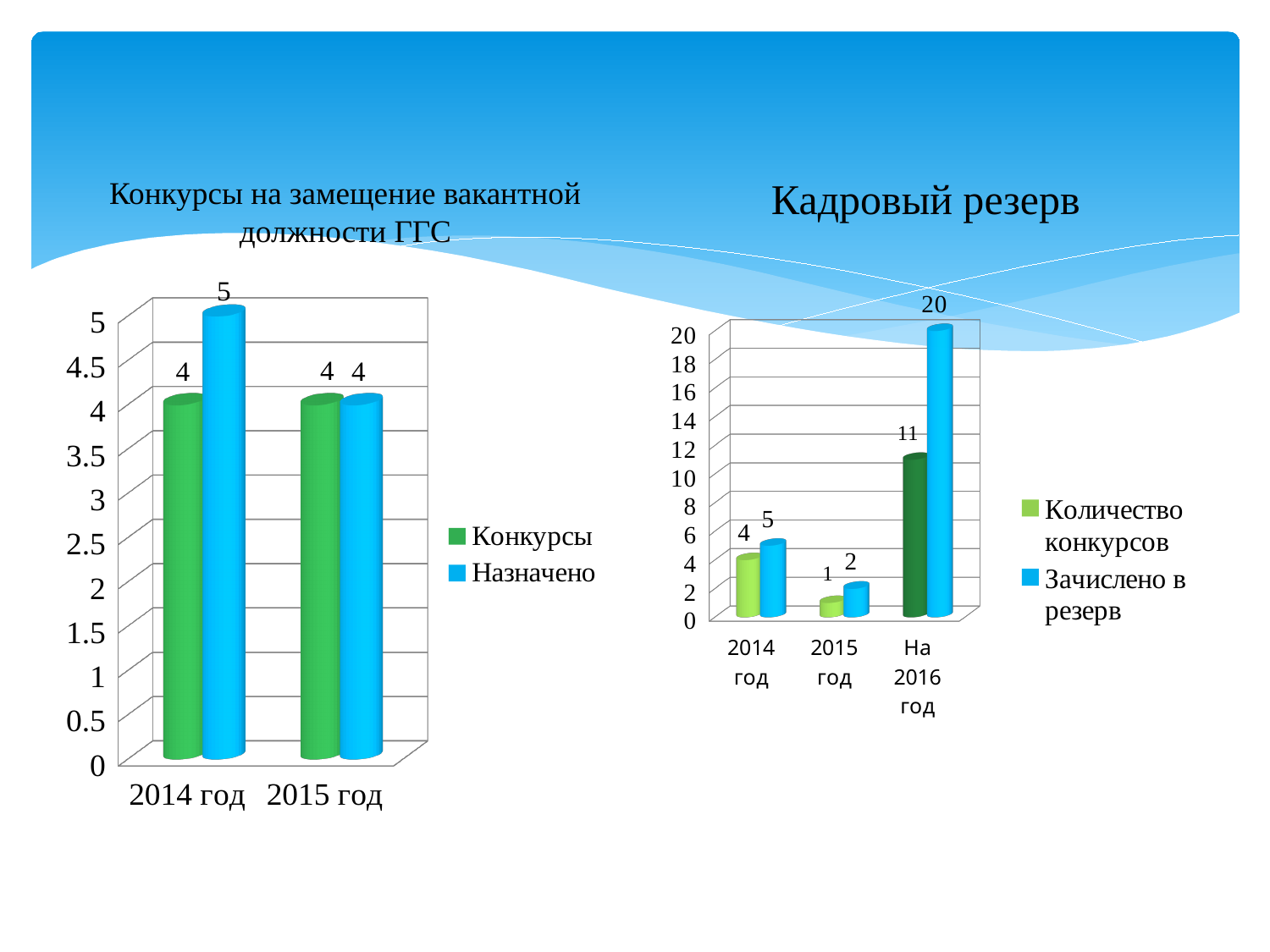
In the chart titled "Кадровый резерв", which is larger for 2014 год: "Количество конкурсов" or "Зачислено в резерв"? Зачислено в резерв In the chart titled "Конкурсы на замещение вакантной должности ГГС", what is the value of "Назначено" for 2014 год? 5 In the chart titled "Кадровый резерв", what is the value of "Количество конкурсов" for 2015 год? 1 In the chart titled "Кадровый резерв", what is the value of "Зачислено в резерв" for На 2016 год? 20 In the chart titled "Кадровый резерв", what is the difference between "Зачислено в резерв" and "Количество конкурсов" for На 2016 год? 9 In the chart titled "Конкурсы на замещение вакантной должности ГГС", what is the difference between "Назначено" and "Конкурсы" for 2014 год? 1 In the chart titled "Кадровый резерв", which category has the lowest value for "Количество конкурсов"? 2015 год In the chart titled "Кадровый резерв", which category has the highest value for "Зачислено в резерв"? На 2016 год In the chart titled "Кадровый резерв", how many categories are shown on the x axis? 3 In the chart titled "Конкурсы на замещение вакантной должности ГГС", how many series does the legend list? 2 What type of chart is the chart titled "Кадровый резерв"? Bar chart In the chart titled "Конкурсы на замещение вакантной должности ГГС", what is the value of "Конкурсы" for 2015 год? 4